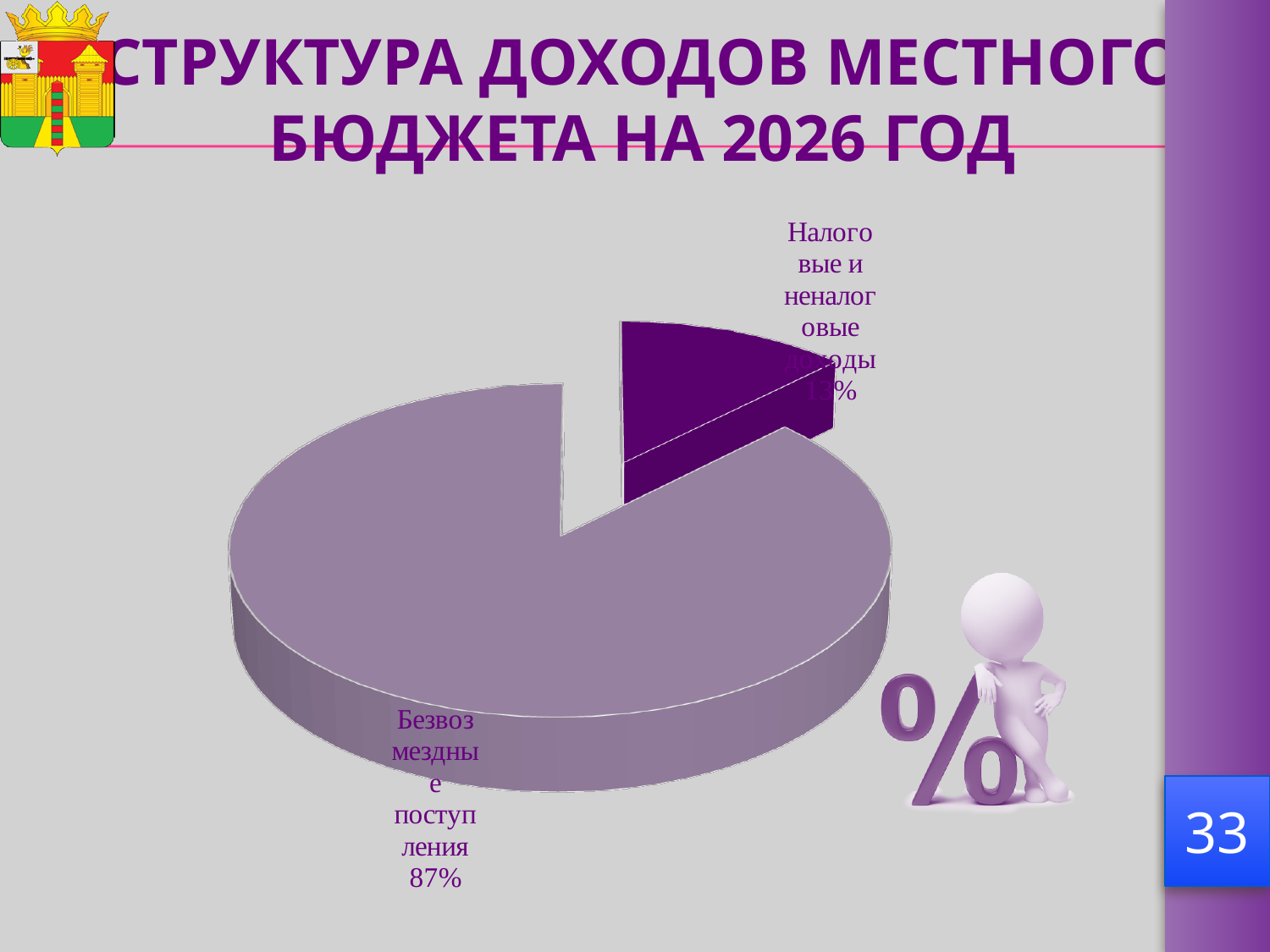
Is the share of "Безвозмездные поступления" greater or less than 50%? greater What share of the pie does "Налоговые и неналоговые доходы" have? 13% What kind of chart is shown on the slide? Pie chart What share of the pie does "Безвозмездные поступления" have? 87% How many slices does the pie chart have? 2 What is the difference in percentage points between "Безвозмездные поступления" and "Налоговые и неналоговые доходы"? 74 percentage points Which year does the chart's title refer to? 2026 What is the title of the slide containing the pie chart? СТРУКТУРА ДОХОДОВ МЕСТНОГО БЮДЖЕТА НА 2026 ГОД Which is larger: the share of "Безвозмездные поступления" or the share of "Налоговые и неналоговые доходы"? Безвозмездные поступления Which slice of the pie chart is the smallest? Налоговые и неналоговые доходы Which slice of the pie chart is the largest? Безвозмездные поступления